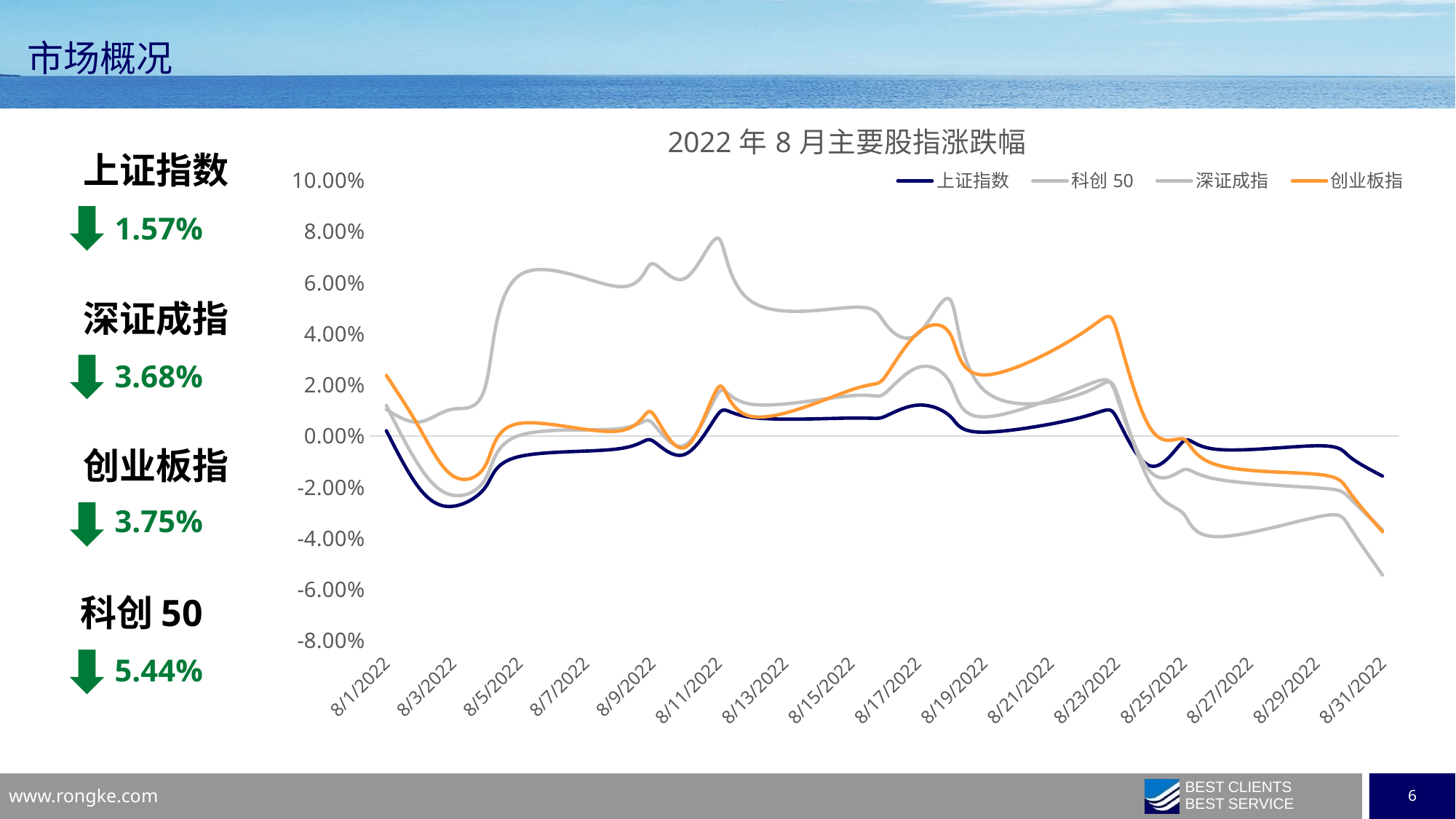
How many date labels are shown on the x axis of the chart? 16 How many series does the chart legend list? 4 Is the value for 上证指数 around 8/3/2022 greater or less than -2.00%? less Does the 上证指数 line rise or fall between 8/23/2022 and 8/31/2022? fall At 8/23/2022, which is higher, 创业板指 or 上证指数? 创业板指 Which colour is used for the 创业板指 line in the chart? orange What type of chart is shown on the slide? line chart At 8/31/2022, which is higher, 上证指数 or 创业板指? 上证指数 Is the value for 上证指数 at 8/31/2022 greater or less than -2.00%? greater Is the value for 创业板指 at its peak around 8/23/2022 greater or less than 4.00%? greater What is the title of the chart? 2022 年 8 月主要股指涨跌幅